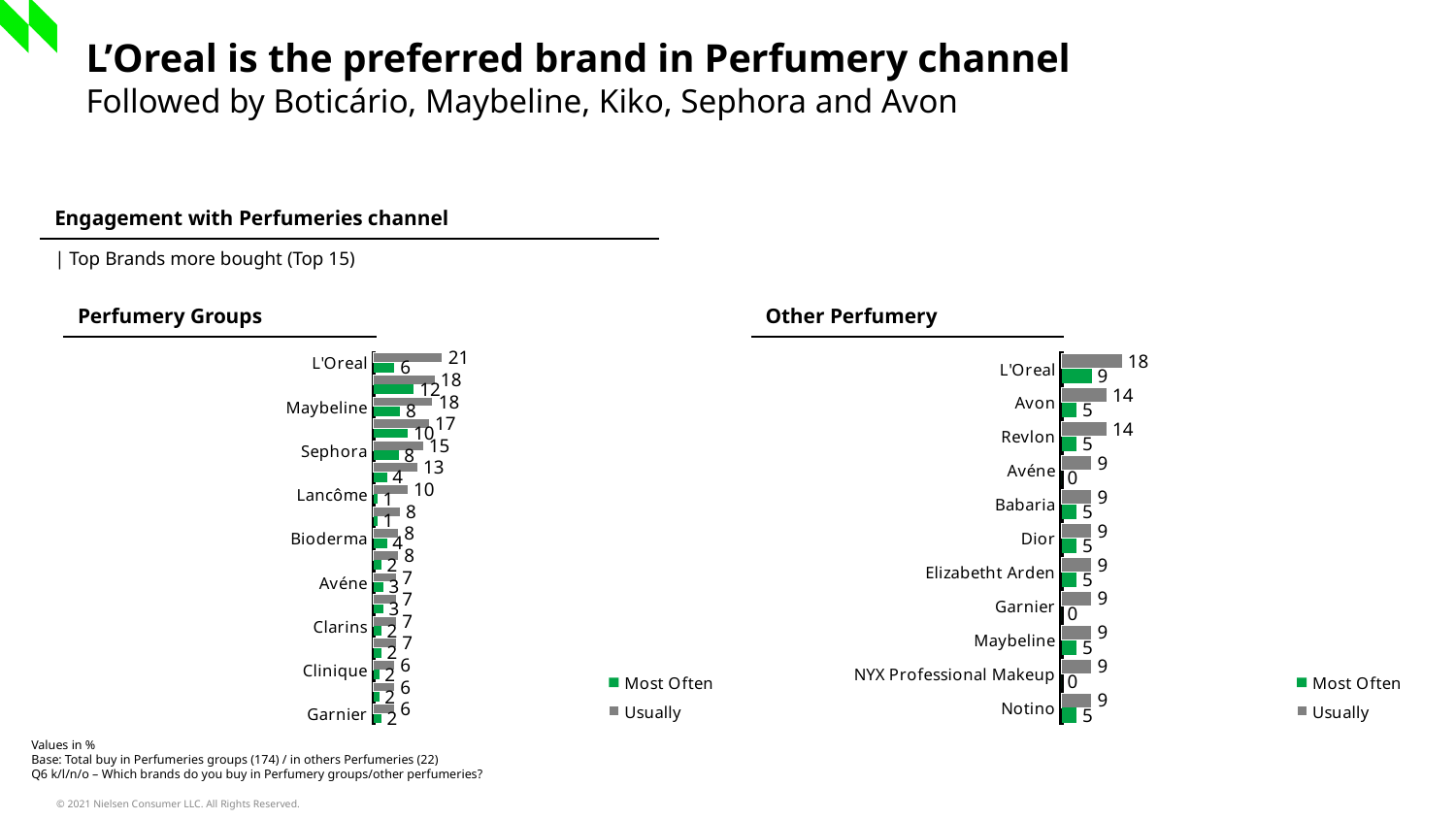
How many brands are shown in the Other Perfumery chart? 11 In the Other Perfumery chart, which has the larger Usually value, Avon or Dior? Avon In the Other Perfumery chart, what is the Most Often value for L'Oreal? 9 In the Perfumery Groups chart, what is the difference between the Usually and Most Often values for L'Oreal? 15 In the Perfumery Groups chart, what is the Most Often value for Lancôme? 1 In the Other Perfumery chart, what is the Most Often value for Avéne? 0 In the Other Perfumery chart, what is the Usually value for Avon? 14 How many series does the legend of the Other Perfumery chart list? 2 In the Perfumery Groups chart, what is the Usually value for Sephora? 15 In the Perfumery Groups chart, which brand has the highest Usually value? L'Oreal In the Perfumery Groups chart, what is the Most Often value for L'Oreal? 6 In the Perfumery Groups chart, what is the Usually value for L'Oreal? 21